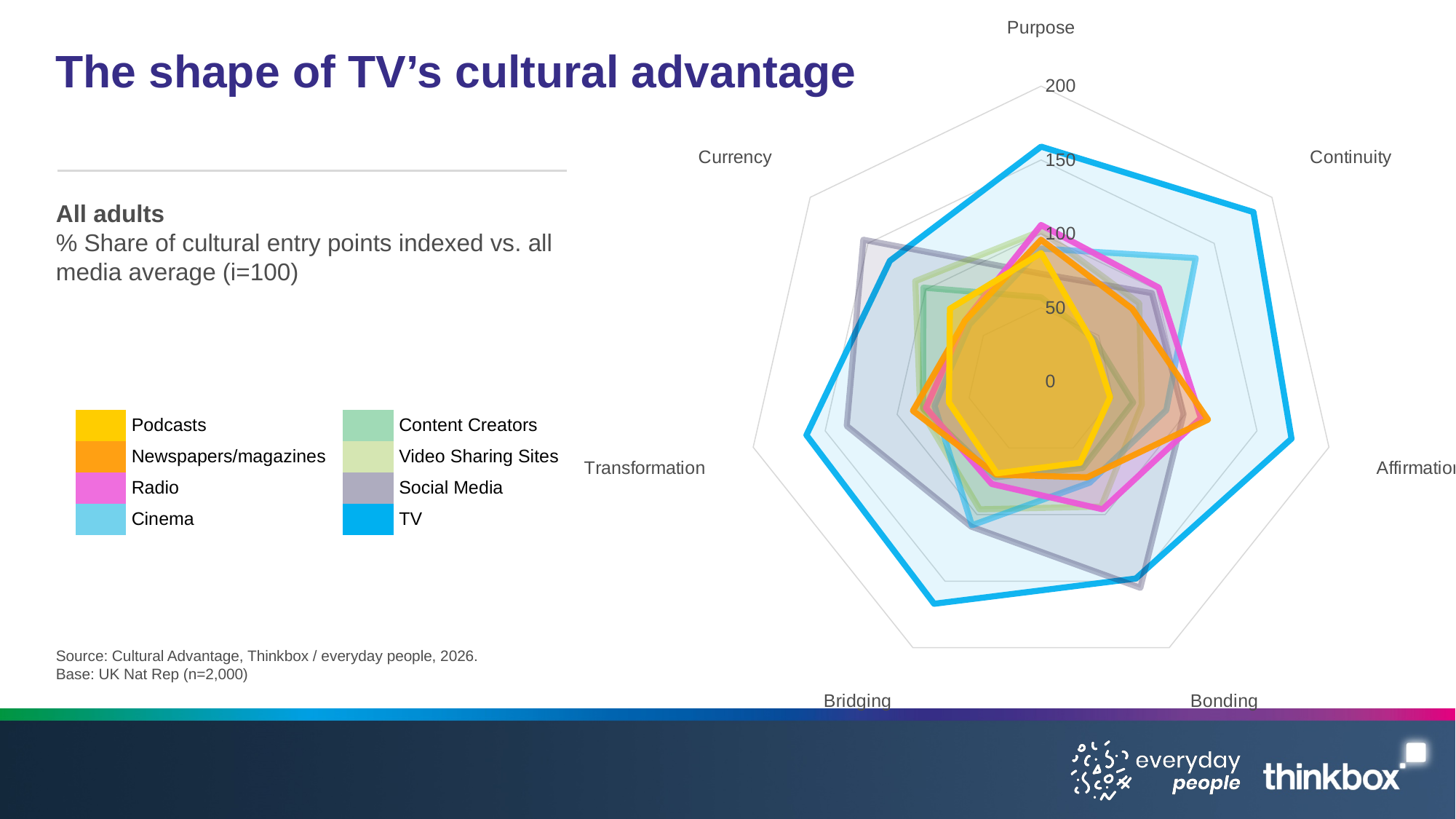
Is the value for TV on the Purpose axis greater or less than 100? greater What kind of chart is shown on the slide? Radar chart How many axes (cultural entry points) does the radar chart have? 7 Which series has the lowest value on the Purpose axis? Content Creators Is the value for TV on the Continuity axis greater or less than 150? greater Which series has the highest value on the Purpose axis? TV Is the value for Podcasts on the Purpose axis greater or less than 100? less Which series has the highest value on the Continuity axis? TV How many series does the legend list? 8 What is the maximum value shown on the radar chart's scale? 200 Which is larger on the Affirmation axis, TV or Podcasts? TV What is the title of the chart slide? The shape of TV's cultural advantage